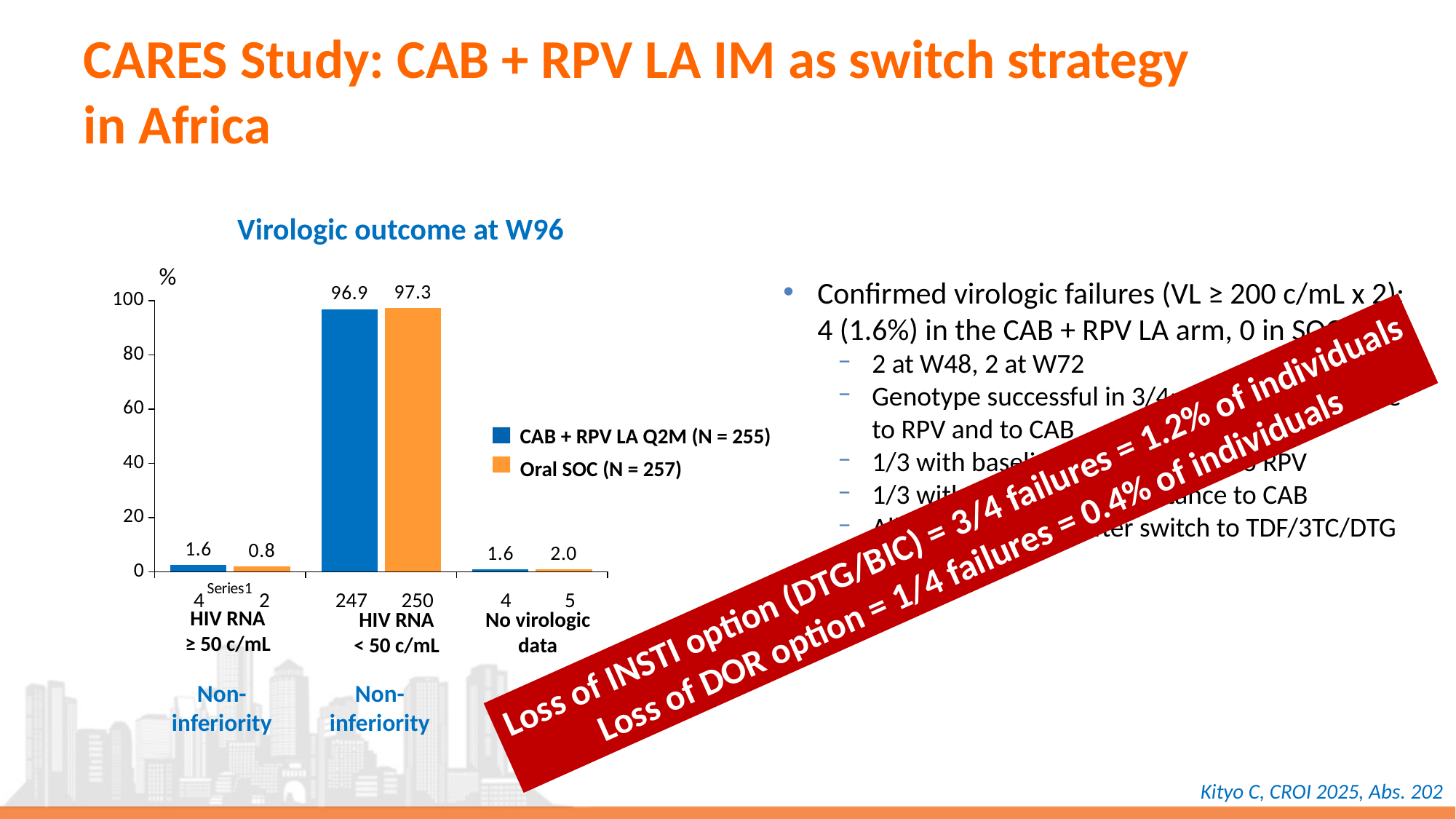
What is the value for CAB + RPV LA Q2M in the HIV RNA ≥ 50 c/mL category? 1.6 How many series does the legend list? 2 What is the value for Oral SOC in the HIV RNA < 50 c/mL category? 97.3 Is the value for CAB + RPV LA Q2M in the HIV RNA < 50 c/mL category greater or less than 80? greater What is the difference between the Oral SOC and CAB + RPV LA Q2M values in the HIV RNA < 50 c/mL category? 0.4 Which category has the highest value for the Oral SOC series? HIV RNA < 50 c/mL What is the title of the chart? Virologic outcome at W96 How many categories are shown on the x axis of the chart? 3 What kind of chart is shown on the slide? bar chart Which series has the larger value in the HIV RNA ≥ 50 c/mL category? CAB + RPV LA Q2M What is the value for CAB + RPV LA Q2M in the HIV RNA < 50 c/mL category? 96.9 What is the value for Oral SOC in the No virologic data category? 2.0